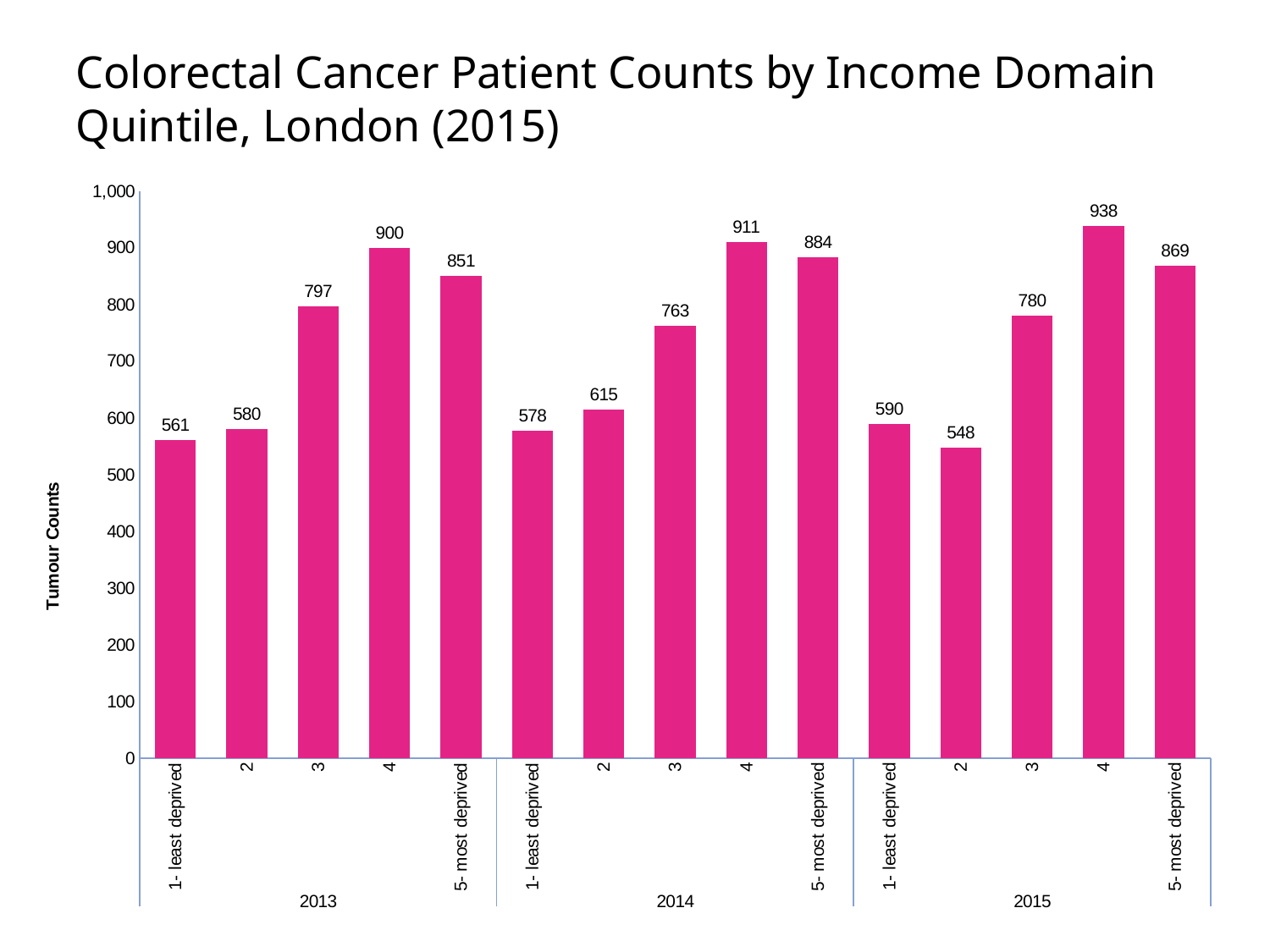
Is the tumour count for quintile 3 in 2015 greater or less than 700? greater Which bar has the highest tumour count on the chart? Quintile 4 in 2015 (938) What kind of chart is shown on the slide? Bar chart What is the tumour count for '5- most deprived' in 2014? 884 Within 2013, do the tumour counts rise or fall from quintile 1 to quintile 4? Rise Which bar has the lowest tumour count on the chart? Quintile 2 in 2015 (548) What is the label of the vertical axis? Tumour Counts How many bars are plotted on the chart? 15 What is the difference between the tumour counts for quintile 4 and quintile 3 in 2014? 148 What is the tumour count for quintile 2 in 2015? 548 What is the tumour count for quintile 4 in 2013? 900 Which is larger: the tumour count for '1- least deprived' in 2013 or in 2015? 2015